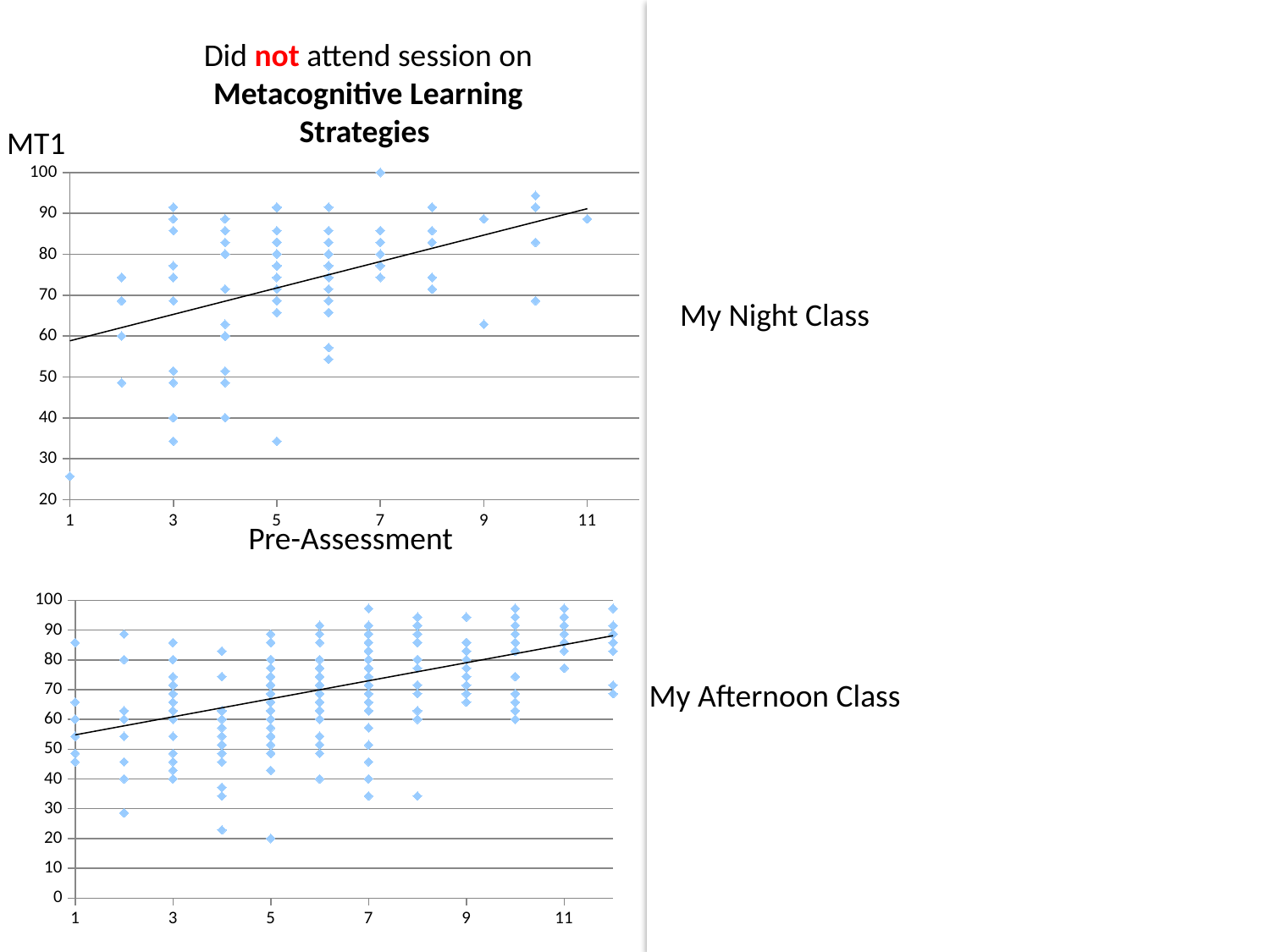
In the 'My Night Class' chart, what is the highest MT1 value plotted? 100 What kind of chart is the 'My Night Class' chart? scatter chart In the 'My Afternoon Class' chart, does the trend line rise or fall as Pre-Assessment increases? rises What is the label of the horizontal axis on the 'My Night Class' chart? Pre-Assessment In the 'My Night Class' chart, is the highest point at Pre-Assessment 10 greater or less than 90? greater In the 'My Night Class' chart, is the MT1 value of the point at Pre-Assessment 1 greater or less than 30? less In the 'My Afternoon Class' chart, is the lowest point at Pre-Assessment 11 greater or less than 70? greater In the 'My Afternoon Class' chart, what is the lowest MT1 value plotted? 20 What kind of chart is the 'My Afternoon Class' chart? scatter chart What is the label of the vertical axis on the 'My Night Class' chart? MT1 In the 'My Night Class' chart, does the trend line rise or fall as Pre-Assessment increases? rises